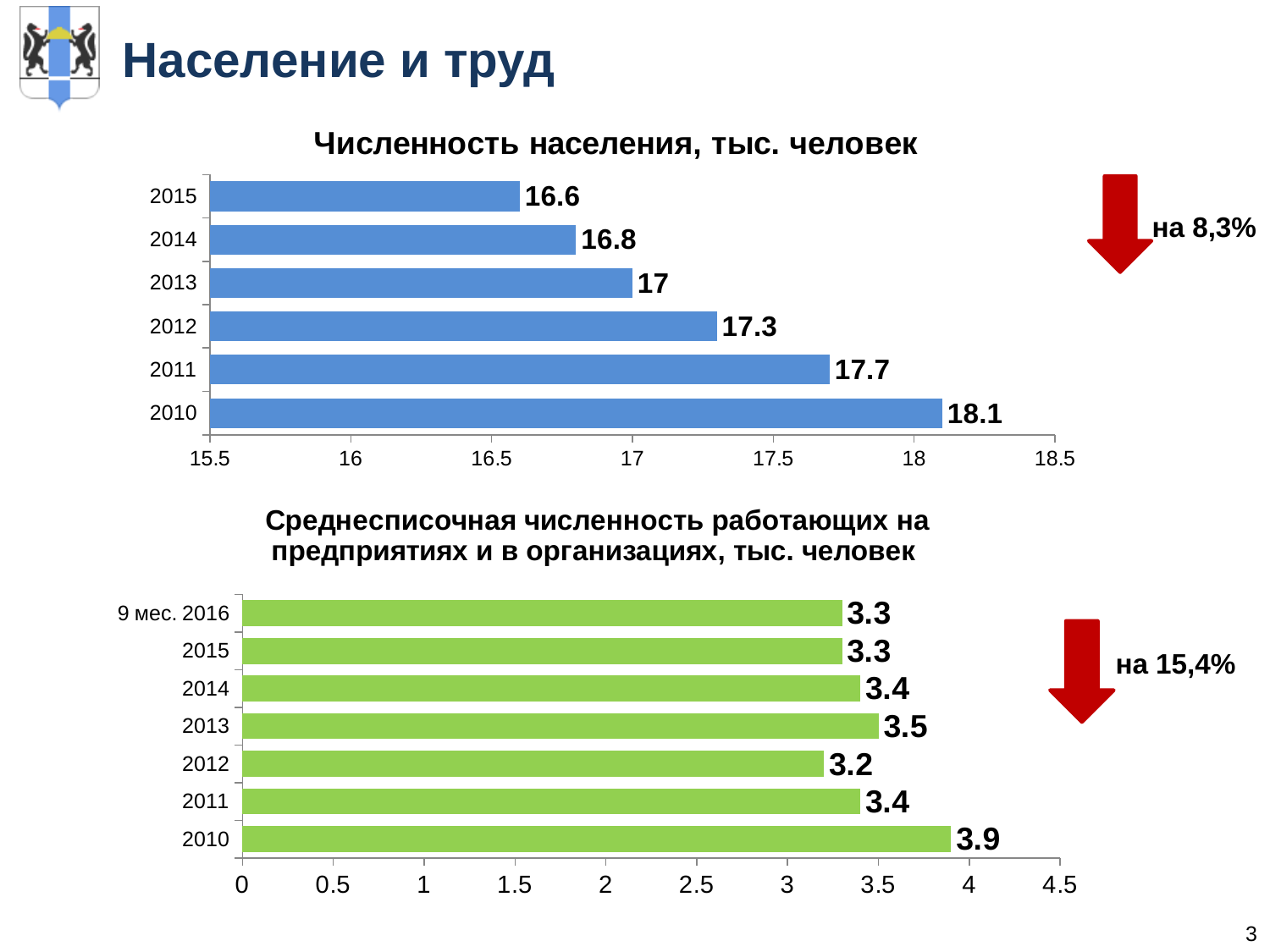
In the chart 'Численность населения, тыс. человек', which year has the lowest value? 2015 In the bottom chart 'Среднесписочная численность работающих на предприятиях и в организациях, тыс. человек', which category has the highest value? 2010 In the bottom chart 'Среднесписочная численность работающих на предприятиях и в организациях, тыс. человек', how many categories are shown? 7 What type of chart is the top chart 'Численность населения, тыс. человек'? bar chart In the bottom chart 'Среднесписочная численность работающих на предприятиях и в организациях, тыс. человек', which is larger: the value for 2013 or the value for 2012? 2013 In the chart 'Численность населения, тыс. человек', how many years are shown? 6 In the bottom chart 'Среднесписочная численность работающих на предприятиях и в организациях, тыс. человек', what is the value for '9 мес. 2016'? 3.3 In the chart 'Численность населения, тыс. человек', what is the value for 2010? 18.1 In the bottom chart 'Среднесписочная численность работающих на предприятиях и в организациях, тыс. человек', what is the value for 2012? 3.2 In the chart 'Численность населения, тыс. человек', what is the difference between the values for 2010 and 2015? 1.5 In the chart 'Численность населения, тыс. человек', is the value for 2012 greater or less than 17? greater In the chart 'Численность населения, тыс. человек', what is the value for 2013? 17